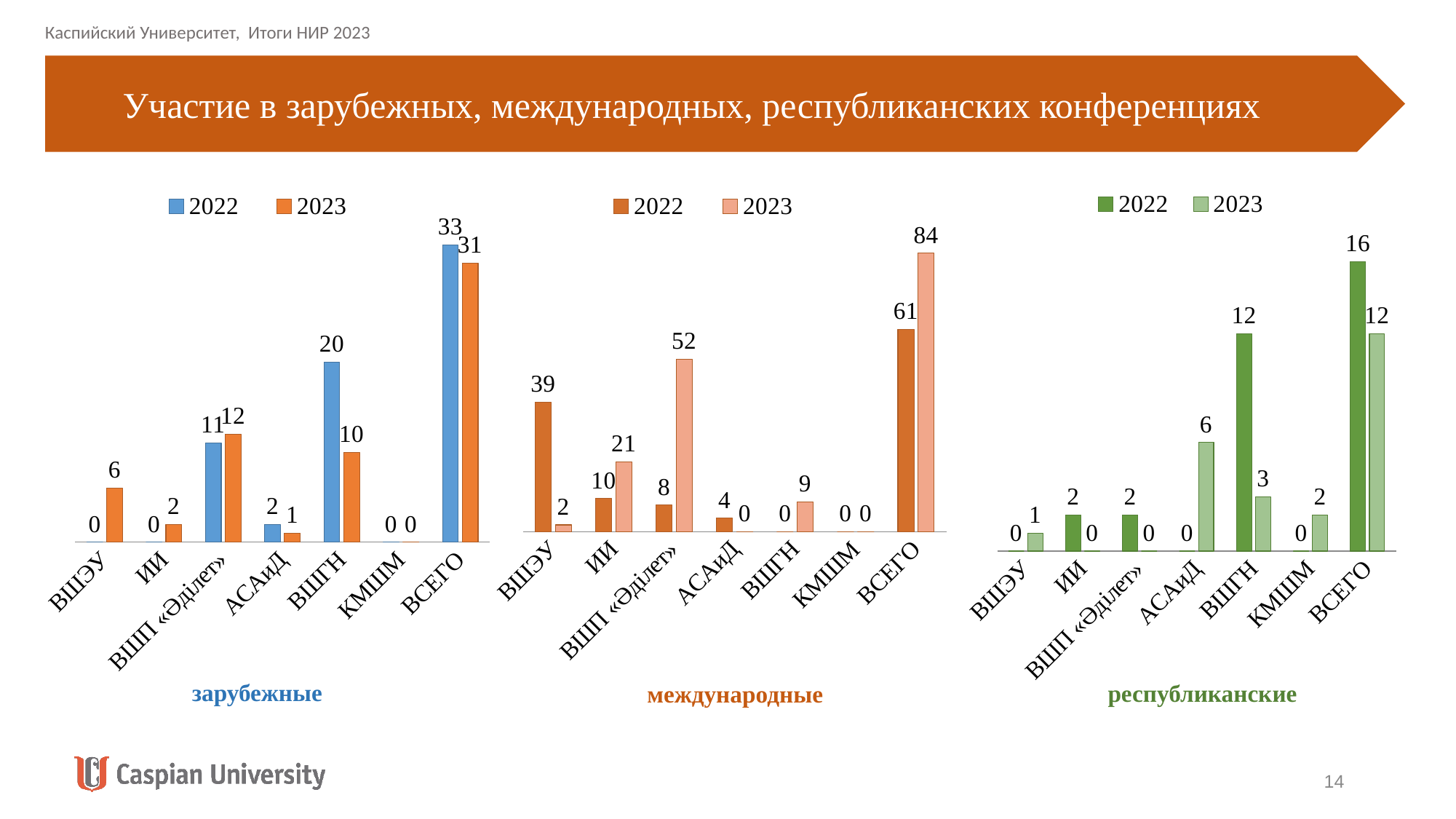
In the middle chart (международные), what is the value for ВШЭУ in 2022? 39 In the middle chart (международные), what is the difference between the 2023 and 2022 values for ВСЕГО? 23 How many series does the legend of the right chart (республиканские) list? 2 What type of chart is the middle chart (международные)? Bar chart In the left chart (зарубежные), what is the value for ВШГН in 2022? 20 In the left chart (зарубежные), which is larger for ВШГН: the 2022 value or the 2023 value? 2022 In the middle chart (международные), what is the value for ВШП «Әділет» in 2023? 52 In the right chart (республиканские), what is the value for АСАиД in 2023? 6 In the middle chart (международные), which is larger for ИИ: the 2022 value or the 2023 value? 2023 How many categories are shown on the x axis of the left chart (зарубежные)? 7 In the left chart (зарубежные), what is the value for ВСЕГО in 2023? 31 In the right chart (республиканские), which category has the highest 2022 value? ВСЕГО